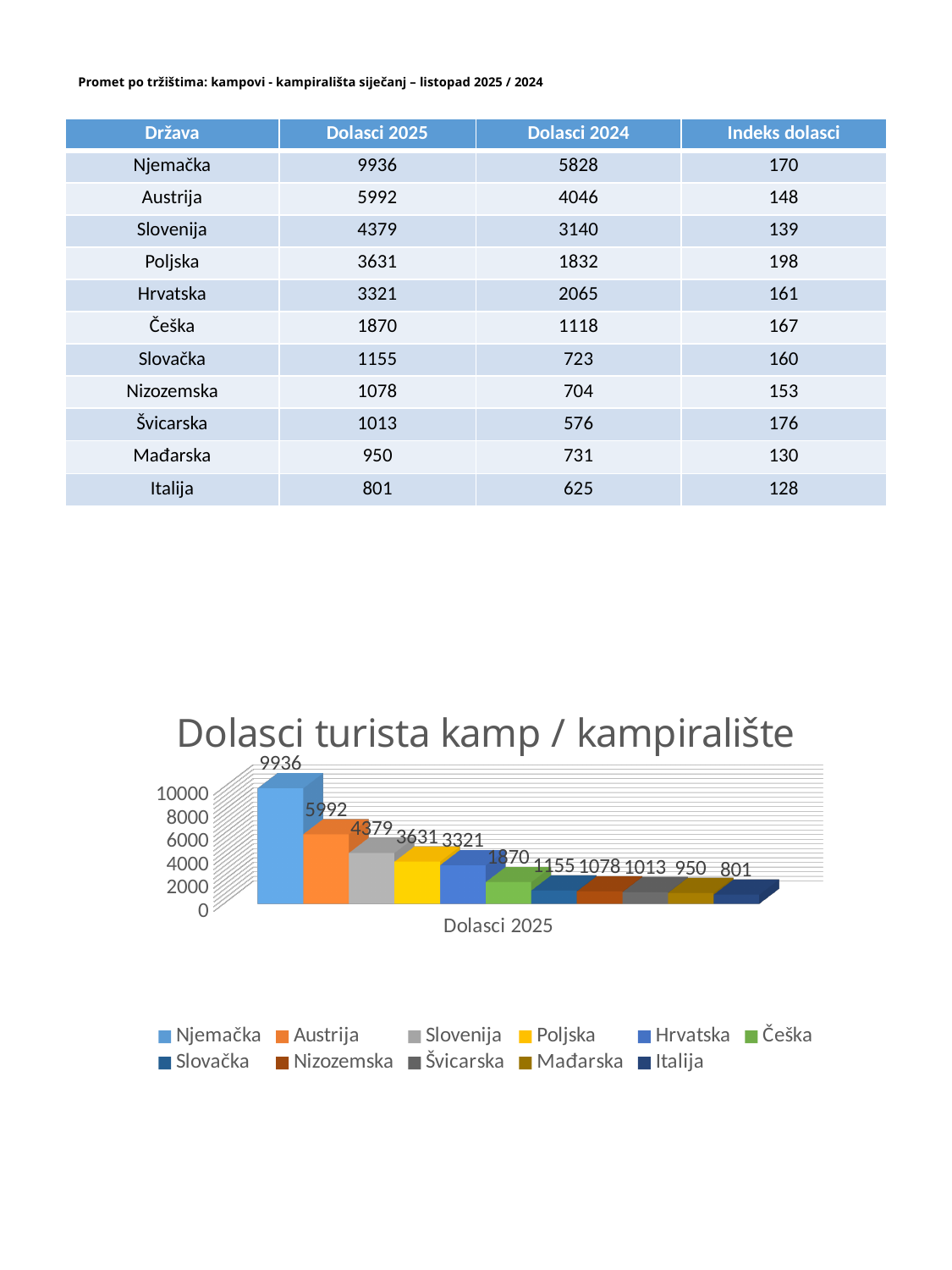
What is the title of the chart? Dolasci turista kamp / kampiralište What type of chart is shown on the slide? bar chart Which country has the highest value in the chart? Njemačka How many series does the legend list? 11 What is the difference between the values for Njemačka and Austrija? 3944 What is the value for Njemačka in the chart? 9936 Which country has the lowest value in the chart? Italija What is the value for Švicarska in the chart? 1013 Which is larger, the value for Poljska or the value for Hrvatska? Poljska What is the x-axis category label shown below the bars? Dolasci 2025 Is the value for Austrija greater or less than 4000? greater What is the value for Slovenija in the chart? 4379